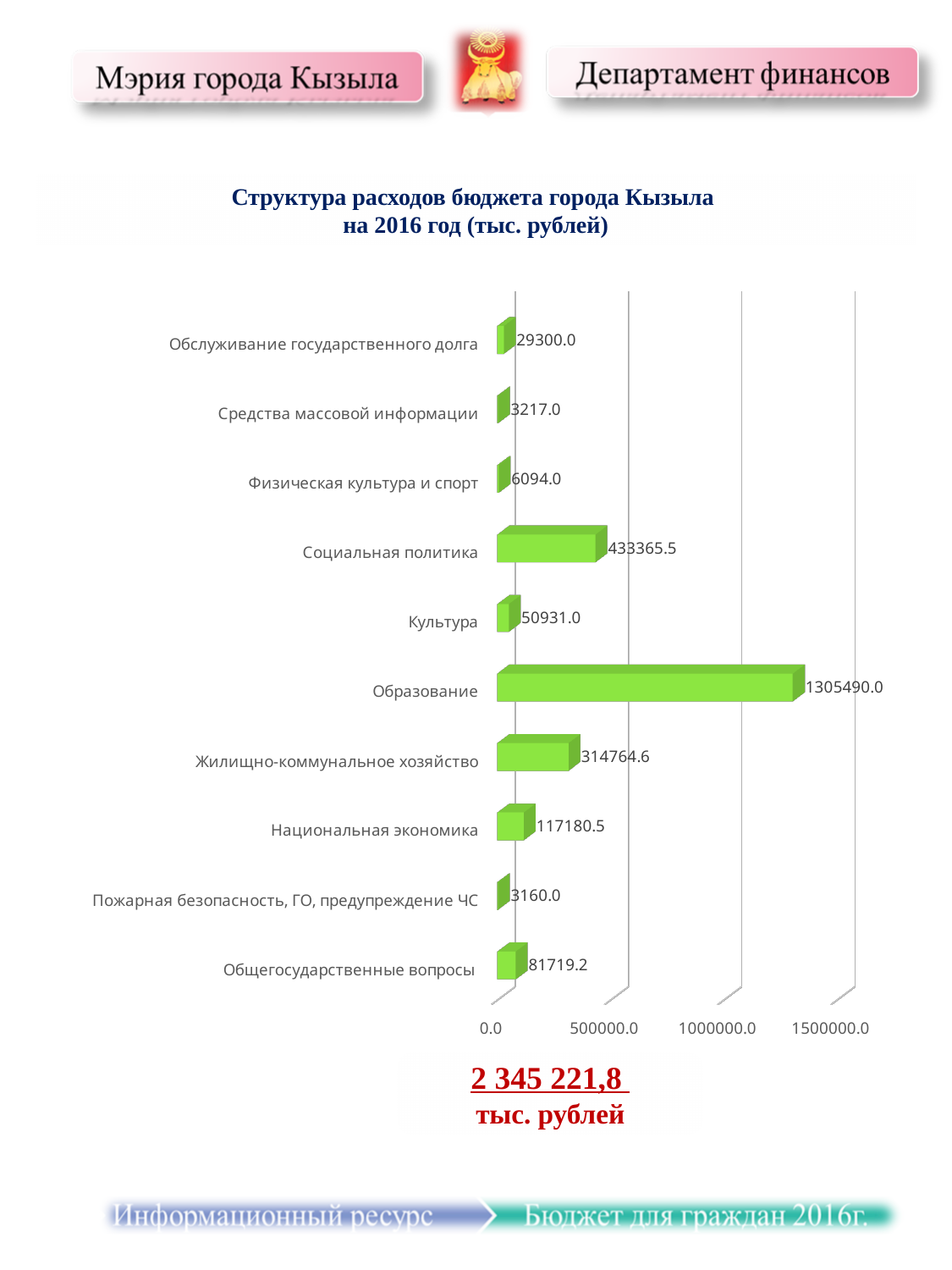
Is the value for Образование greater or less than 1000000.0? greater What is the value for Жилищно-коммунальное хозяйство? 314764.6 Which category has the highest value? Образование What is the value for Образование? 1305490.0 What kind of chart is shown on the slide? bar chart Which is larger, the value for Культура or the value for Обслуживание государственного долга? Культура Which category has the lowest value? Пожарная безопасность, ГО, предупреждение ЧС How many categories are shown in the chart? 10 What is the title of the chart? Структура расходов бюджета города Кызыла на 2016 год (тыс. рублей) What is the value for Общегосударственные вопросы? 81719.2 What is the difference between the values for Социальная политика and Жилищно-коммунальное хозяйство? 118600.9 What is the value for Социальная политика? 433365.5